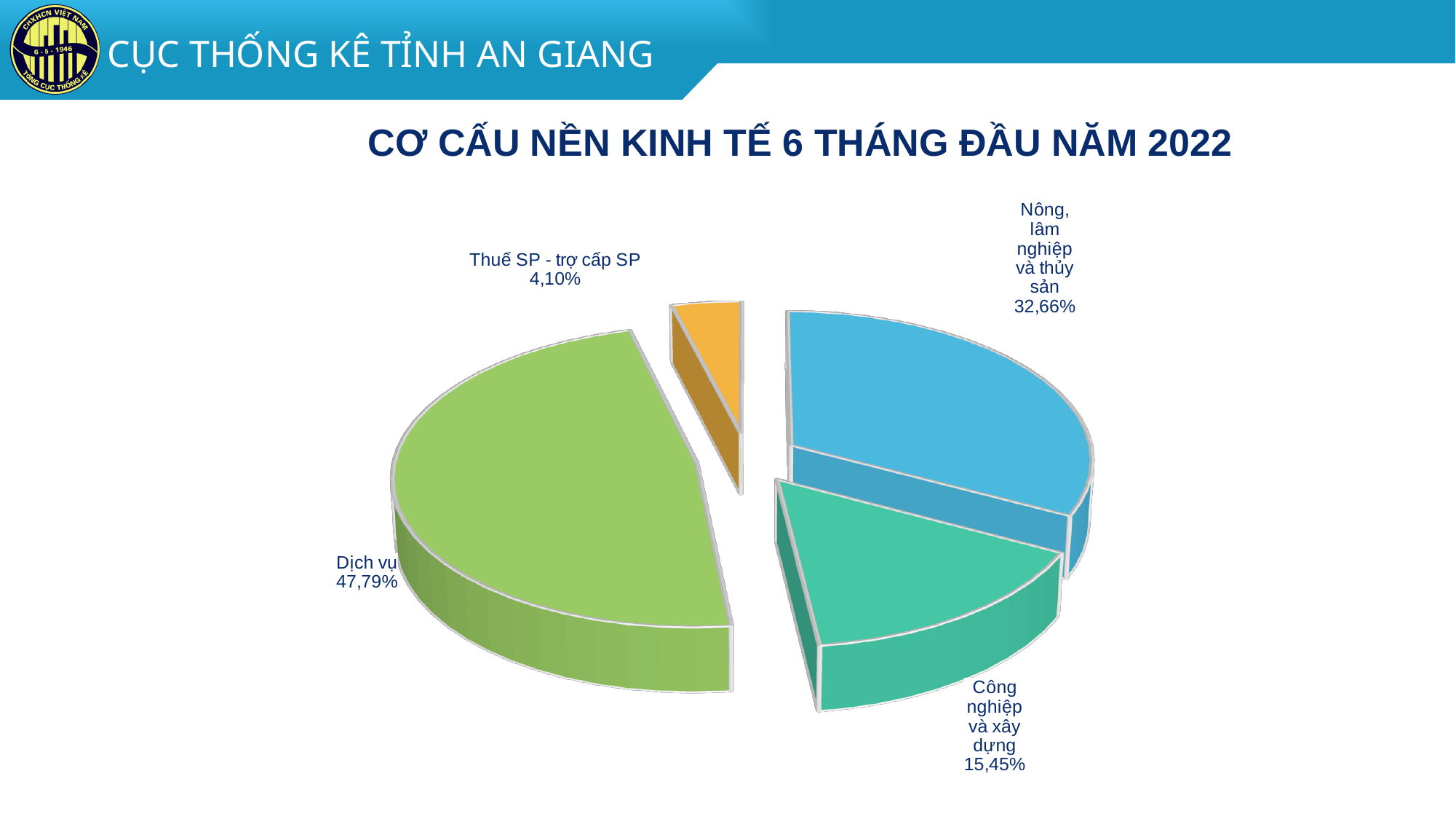
Which category has the largest share of the pie? Dịch vụ Which category has the smallest share of the pie? Thuế SP - trợ cấp SP What is the title of the chart? CƠ CẤU NỀN KINH TẾ 6 THÁNG ĐẦU NĂM 2022 How many slices does the pie chart have? 4 What is the share for Dịch vụ? 47,79% What is the share for Nông, lâm nghiệp và thủy sản? 32,66% What is the difference between the shares of Dịch vụ and Nông, lâm nghiệp và thủy sản? 15,13% What is the share for Công nghiệp và xây dựng? 15,45% Which is larger, the share of Công nghiệp và xây dựng or the share of Thuế SP - trợ cấp SP? Công nghiệp và xây dựng What kind of chart is shown on the slide? Pie chart What is the share for Thuế SP - trợ cấp SP? 4,10% What colour is the slice for Dịch vụ? Green